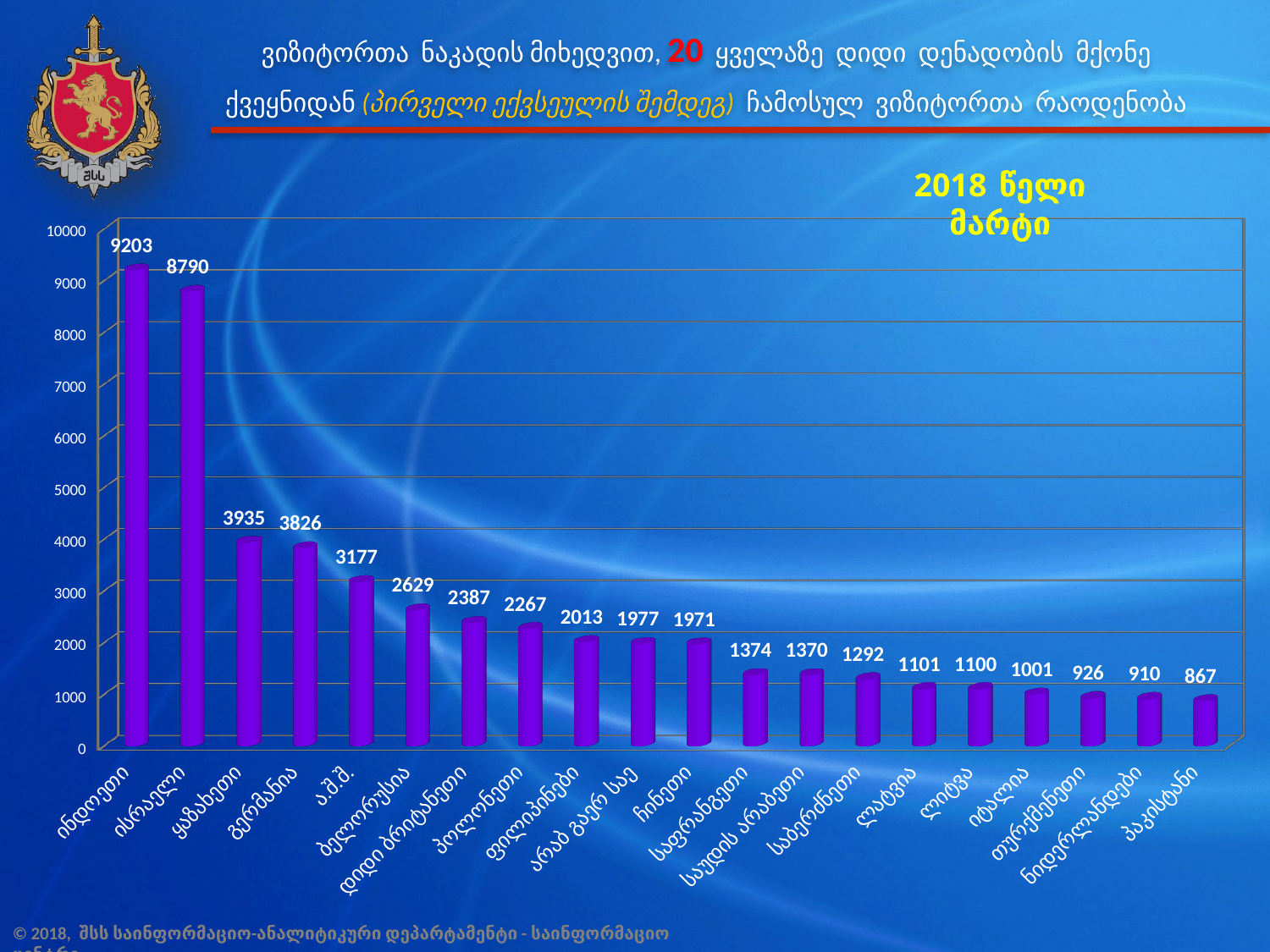
What is the value for პაკისტანი? 867 Which category has the highest value? ინდოეთი How many categories are shown in the chart? 20 What is the value for ინდოეთი? 9203 What is the difference between the values for ინდოეთი and ისრაელი? 413 Which is larger, the value for ყაზახეთი or the value for ა.შ.შ.? ყაზახეთი What is the value for ჩინეთი? 1971 What period is given in the yellow label above the chart? 2018 წელი მარტი Do the values rise or fall from left to right along the x axis? fall What kind of chart is shown on the slide? bar chart What is the value for გერმანია? 3826 Which category has the lowest value? პაკისტანი